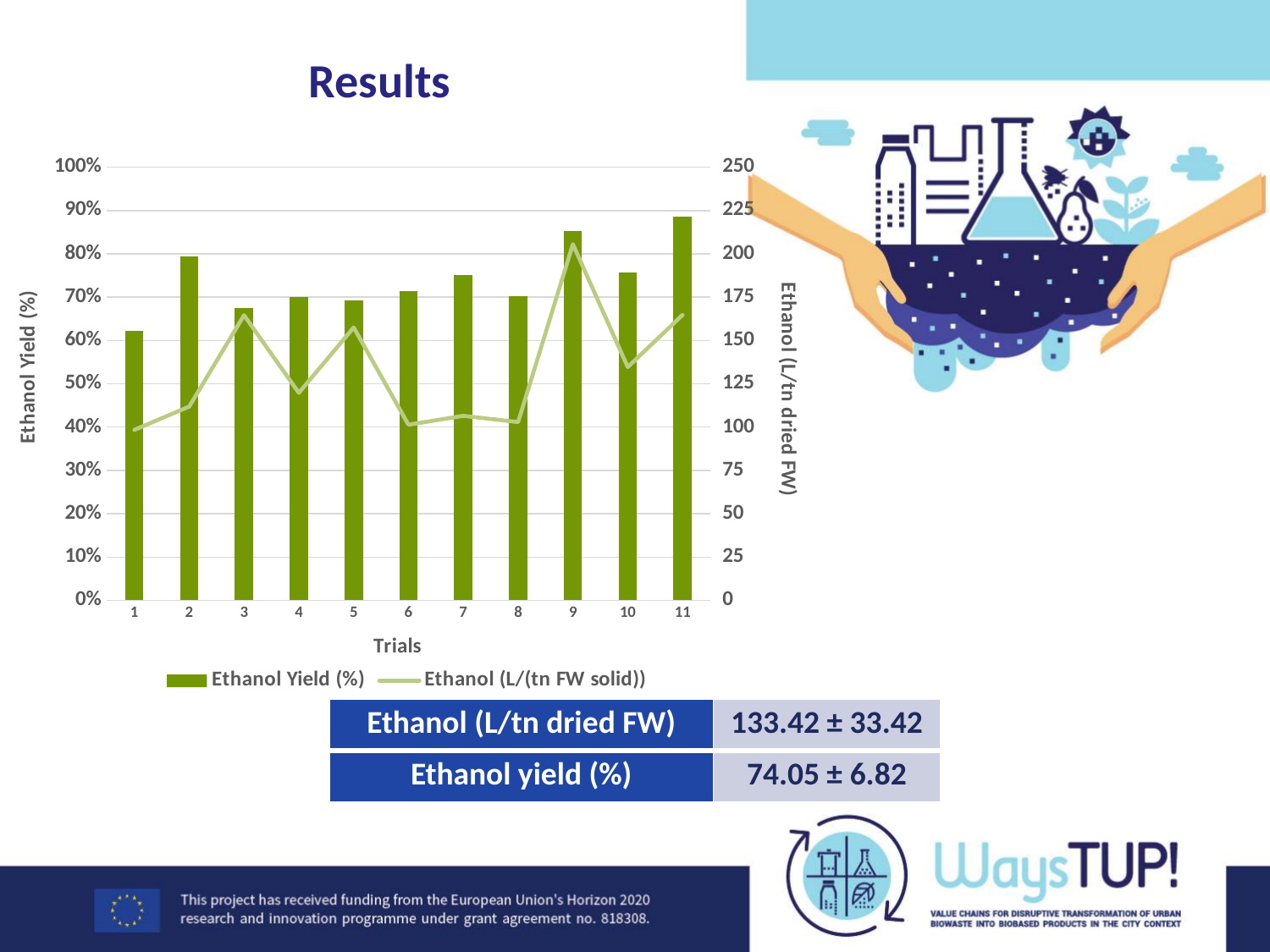
How many trials are shown on the x axis of the chart? 11 Which trial has the larger Ethanol Yield (%) bar, trial 2 or trial 3? Trial 2 What is the title of the x axis of the chart? Trials Which trial has the highest value on the Ethanol (L/(tn FW solid)) line? 9 Is the Ethanol Yield (%) for trial 2 greater or less than 70%? greater Which trial has the highest Ethanol Yield (%) bar? 11 Which trial has the lowest Ethanol Yield (%) bar? 1 Is the Ethanol Yield (%) for trial 1 greater or less than 70%? less What kind of chart is shown on the slide? Combined bar and line chart Is the Ethanol (L/(tn FW solid)) value for trial 9 greater or less than 175? greater How many series does the chart legend list? 2